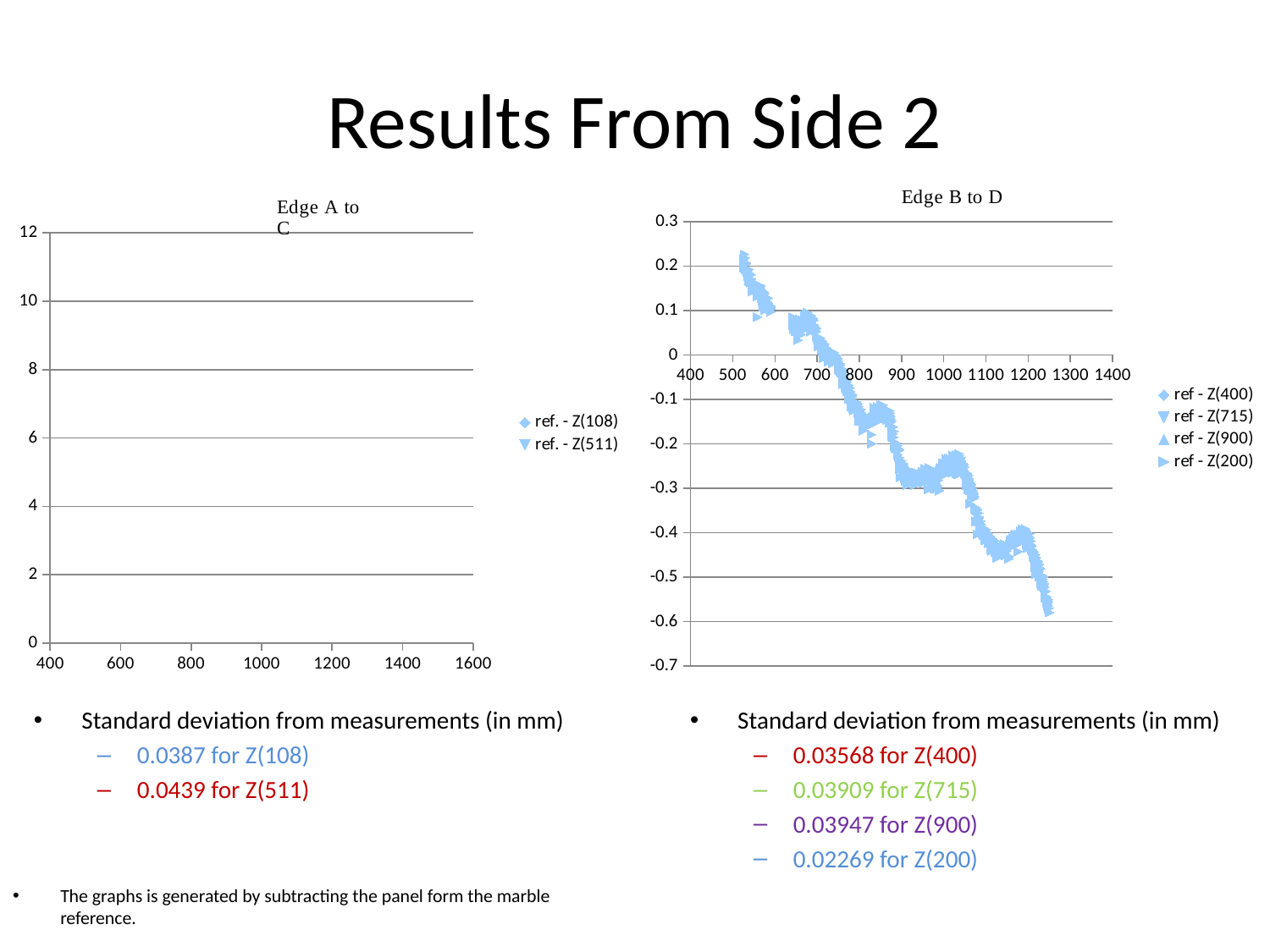
In the 'Edge B to D' chart, are the plotted values near x = 500 greater or less than 0? greater In the 'Edge B to D' chart, which series is listed last in the legend? ref - Z(200) In the 'Edge B to D' chart, do the plotted values rise or fall as the x axis increases? Fall In the 'Edge B to D' chart, are the plotted values near x = 1200 greater or less than -0.2? less How many series does the legend of the 'Edge B to D' chart list? 4 What is the title of the chart on the left of the slide? Edge A to C What is the highest value shown on the y axis of the 'Edge A to C' chart? 12 How many series does the legend of the 'Edge A to C' chart list? 2 In the 'Edge B to D' chart, are the plotted values near x = 1000 greater or less than -0.5? greater What kind of chart is the 'Edge B to D' chart? Scatter chart